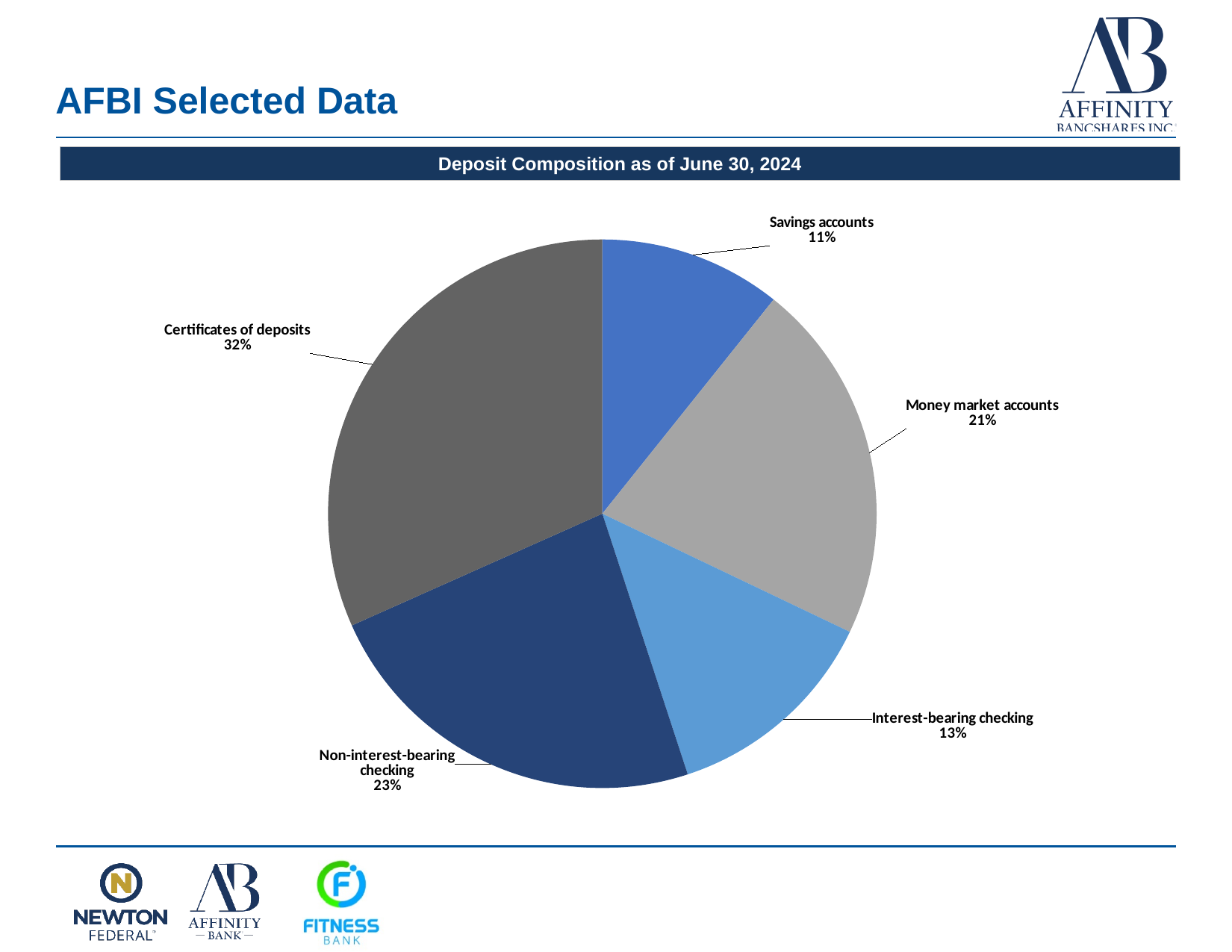
What share of deposits is in non-interest-bearing checking? 23% How many deposit categories are shown in the pie chart? 5 Which deposit category has the smallest share? Savings accounts What type of chart is shown on the slide? pie chart What share of deposits is in interest-bearing checking? 13% What share of deposits is in money market accounts? 21% Which is larger, the share for money market accounts or the share for interest-bearing checking? Money market accounts What is the difference in percentage points between certificates of deposits and non-interest-bearing checking? 9 What is the title of the chart? Deposit Composition as of June 30, 2024 Which deposit category has the largest share? Certificates of deposits